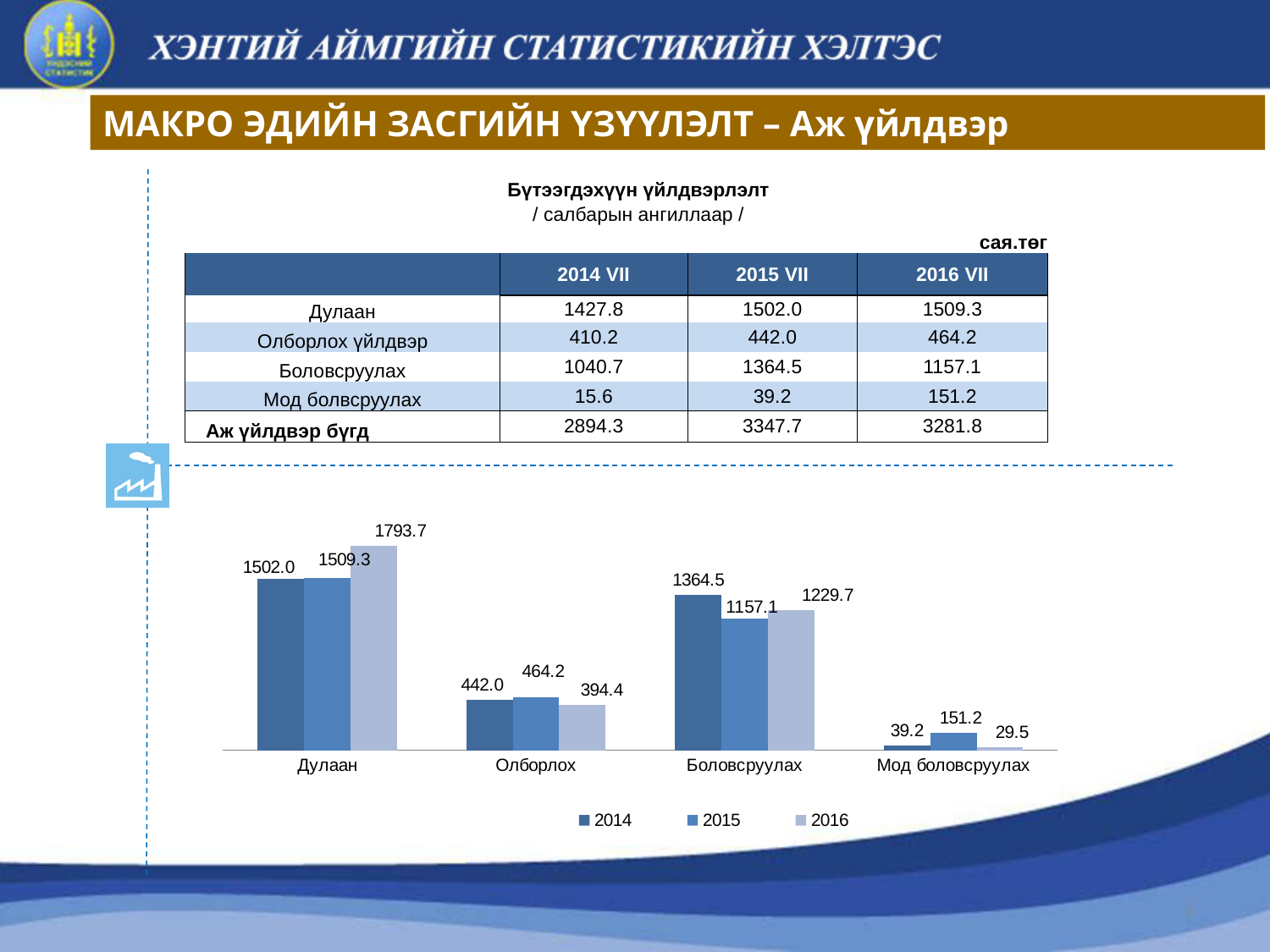
In the bar chart, what is the value for Дулаан in the 2016 series? 1793.7 In the bar chart, which category has the lowest value in the 2014 series? Мод боловсруулах In the bar chart, what is the difference between the 2016 and 2014 values for Дулаан? 291.7 In the bar chart, which is larger for Олборлох: the 2015 value or the 2016 value? 2015 In the bar chart, what is the value for Мод боловсруулах in the 2015 series? 151.2 In the bar chart, what is the value for Боловсруулах in the 2015 series? 1157.1 How many categories are shown on the x axis of the bar chart? 4 How many series does the legend of the bar chart list? 3 In the bar chart, what is the value for Олборлох in the 2014 series? 442.0 In the bar chart, which category has the highest value in the 2016 series? Дулаан In the bar chart, what is the difference between the 2014 and 2015 values for Боловсруулах? 207.4 What kind of chart is shown on the slide? Bar chart